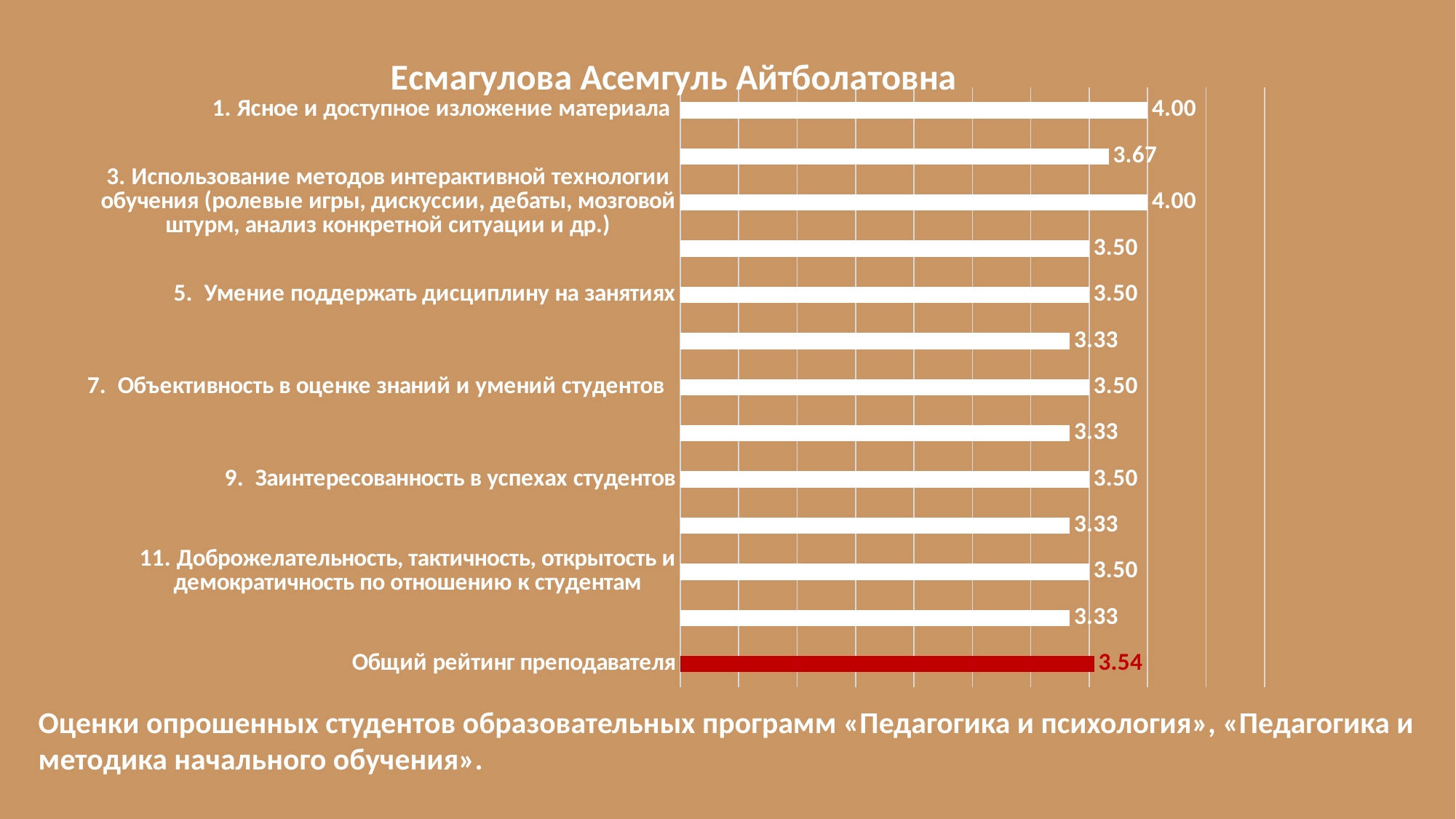
What is the value for "3. Использование методов интерактивной технологии обучения"? 4.00 What kind of chart is shown on the slide? Bar chart What is the lowest value shown on the chart? 3.33 How many bars are plotted on the chart? 13 What is the value for "Общий рейтинг преподавателя"? 3.54 What is the value for "7. Объективность в оценке знаний и умений студентов"? 3.50 What is the value for "5. Умение поддержать дисциплину на занятиях"? 3.50 What is the highest value shown on the chart? 4.00 Which is larger: the value for "1. Ясное и доступное изложение материала" or the value for "9. Заинтересованность в успехах студентов"? 1. Ясное и доступное изложение материала What is the value for "1. Ясное и доступное изложение материала"? 4.00 What is the difference between the value for "1. Ясное и доступное изложение материала" and the value for "5. Умение поддержать дисциплину на занятиях"? 0.50 What is the title of the chart? Есмагулова Асемгуль Айтболатовна